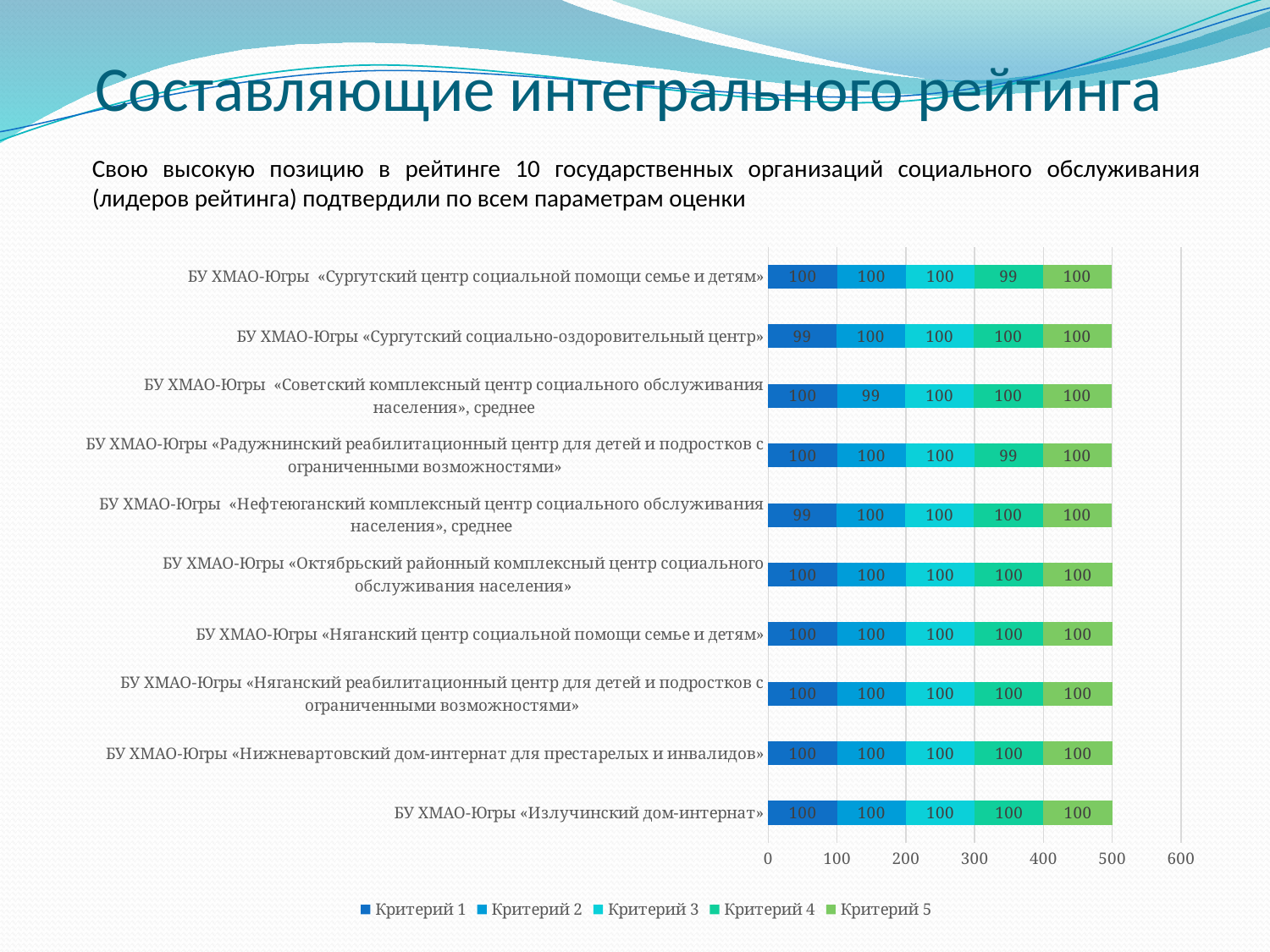
What is the value of Критерий 2 for БУ ХМАО-Югры «Советский комплексный центр социального обслуживания населения», среднее? 99 What kind of chart is shown on the slide? stacked bar chart What is the difference between the Критерий 1 value for БУ ХМАО-Югры «Нижневартовский дом-интернат для престарелых и инвалидов» and the Критерий 1 value for БУ ХМАО-Югры «Нефтеюганский комплексный центр социального обслуживания населения», среднее? 1 What is the value of Критерий 1 for БУ ХМАО-Югры «Сургутский социально-оздоровительный центр»? 99 What is the value of Критерий 4 for БУ ХМАО-Югры «Сургутский центр социальной помощи семье и детям»? 99 What is the total of the stacked bar for БУ ХМАО-Югры «Нефтеюганский комплексный центр социального обслуживания населения», среднее? 499 How many organisations (categories) are plotted in the chart? 10 How many series does the legend list? 5 Which is larger: the Критерий 4 value for БУ ХМАО-Югры «Радужнинский реабилитационный центр для детей и подростков с ограниченными возможностями» or its Критерий 5 value? Критерий 5 What is the total of the stacked bar for БУ ХМАО-Югры «Няганский центр социальной помощи семье и детям»? 500 What is the name of the last series listed in the legend? Критерий 5 What is the value of Критерий 5 for БУ ХМАО-Югры «Излучинский дом-интернат»? 100